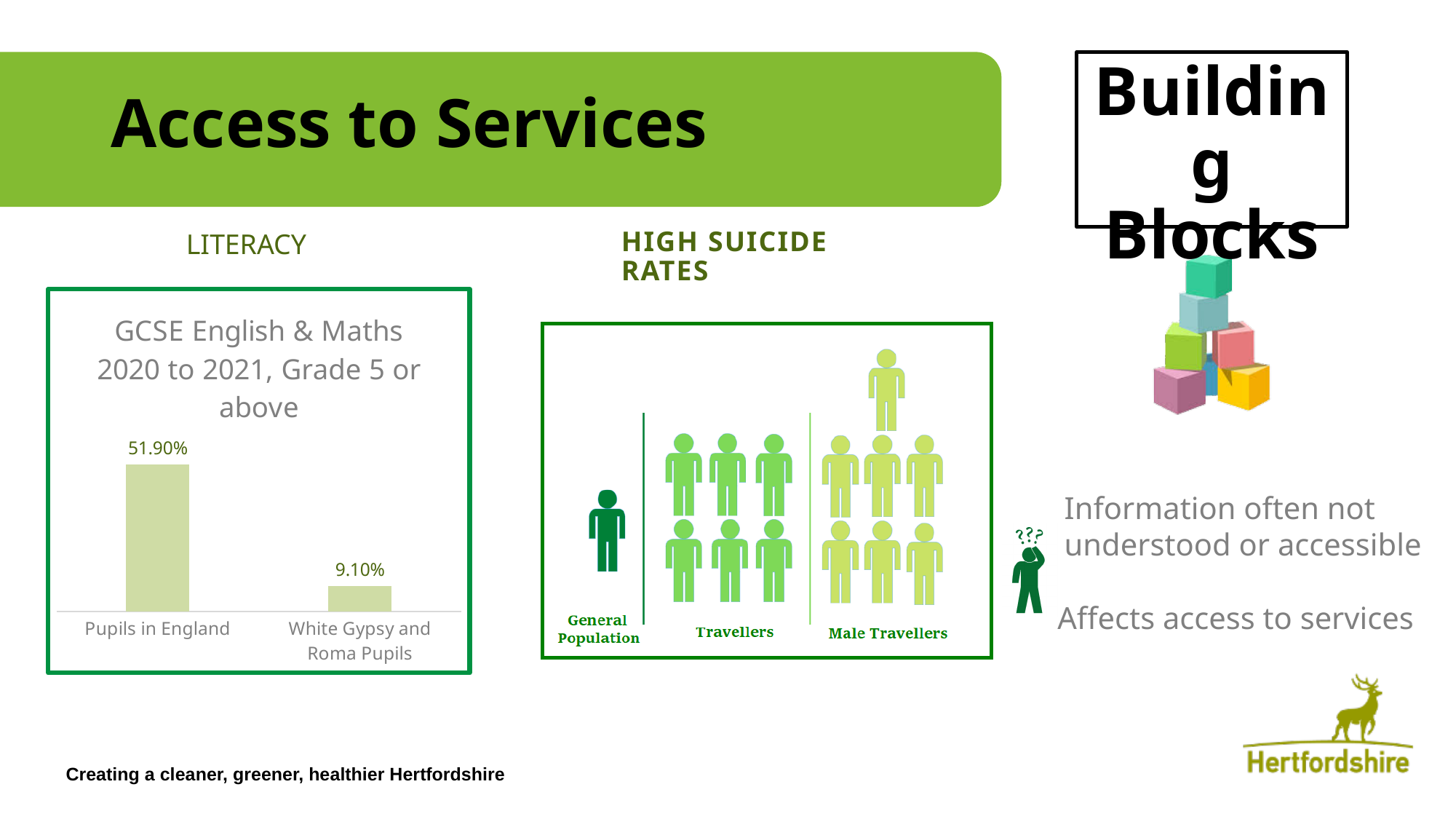
In the GCSE English & Maths chart, which category has the lowest value? White Gypsy and Roma Pupils In the HIGH SUICIDE RATES pictogram, how many person figures are shown for the General Population group? 1 In the GCSE English & Maths chart, what is the difference between the value for Pupils in England and the value for White Gypsy and Roma Pupils? 42.80% How many categories are shown in the GCSE English & Maths chart? 2 In the GCSE English & Maths chart, which category has the highest value? Pupils in England What kind of chart is the GCSE English & Maths chart? Bar chart In the GCSE English & Maths chart, what is the value for Pupils in England? 51.90% In the HIGH SUICIDE RATES pictogram, how many person figures are shown for the Male Travellers group? 7 In the GCSE English & Maths chart, which is larger: the value for Pupils in England or the value for White Gypsy and Roma Pupils? Pupils in England What is the full title of the bar chart under the LITERACY heading? GCSE English & Maths 2020 to 2021, Grade 5 or above In the GCSE English & Maths chart, what is the value for White Gypsy and Roma Pupils? 9.10% In the HIGH SUICIDE RATES pictogram, which group has the most person figures? Male Travellers